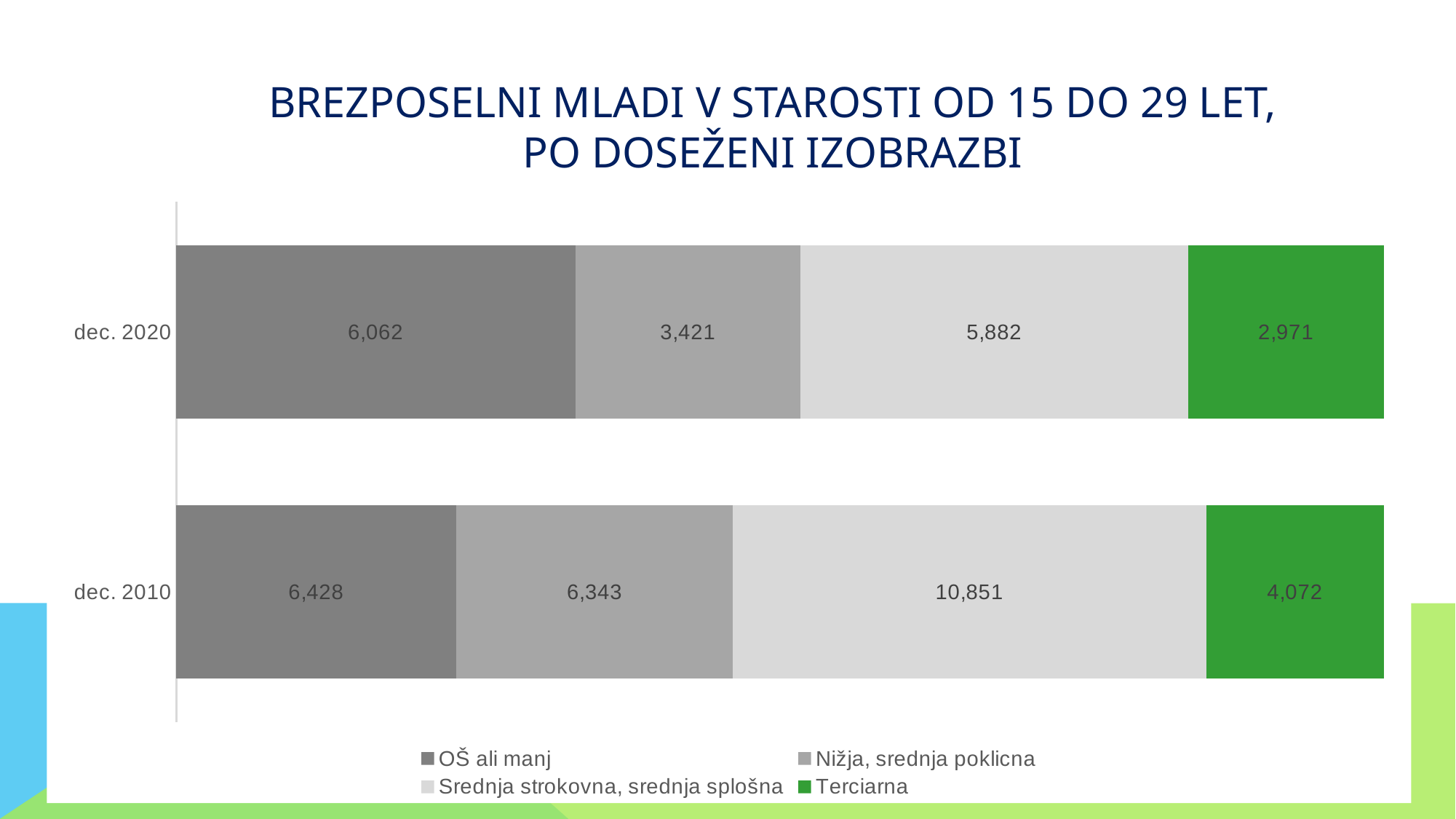
What is the difference between the 'Srednja strokovna, srednja splošna' values for dec. 2010 and dec. 2020? 4,969 What is the value for 'Nižja, srednja poklicna' in dec. 2010? 6,343 What is the difference between the 'Terciarna' values for dec. 2010 and dec. 2020? 1,101 What is the value for 'OŠ ali manj' in dec. 2020? 6,062 What is the value for 'Terciarna' in dec. 2020? 2,971 Which education category has the highest value in dec. 2010? Srednja strokovna, srednja splošna How many series does the legend list? 4 Which education category has the lowest value in dec. 2020? Terciarna What is the total of the dec. 2020 bar? 18,336 Which is larger: 'Nižja, srednja poklicna' in dec. 2010 or in dec. 2020? dec. 2010 What kind of chart is shown on the slide? Stacked bar chart What is the value for 'Srednja strokovna, srednja splošna' in dec. 2010? 10,851